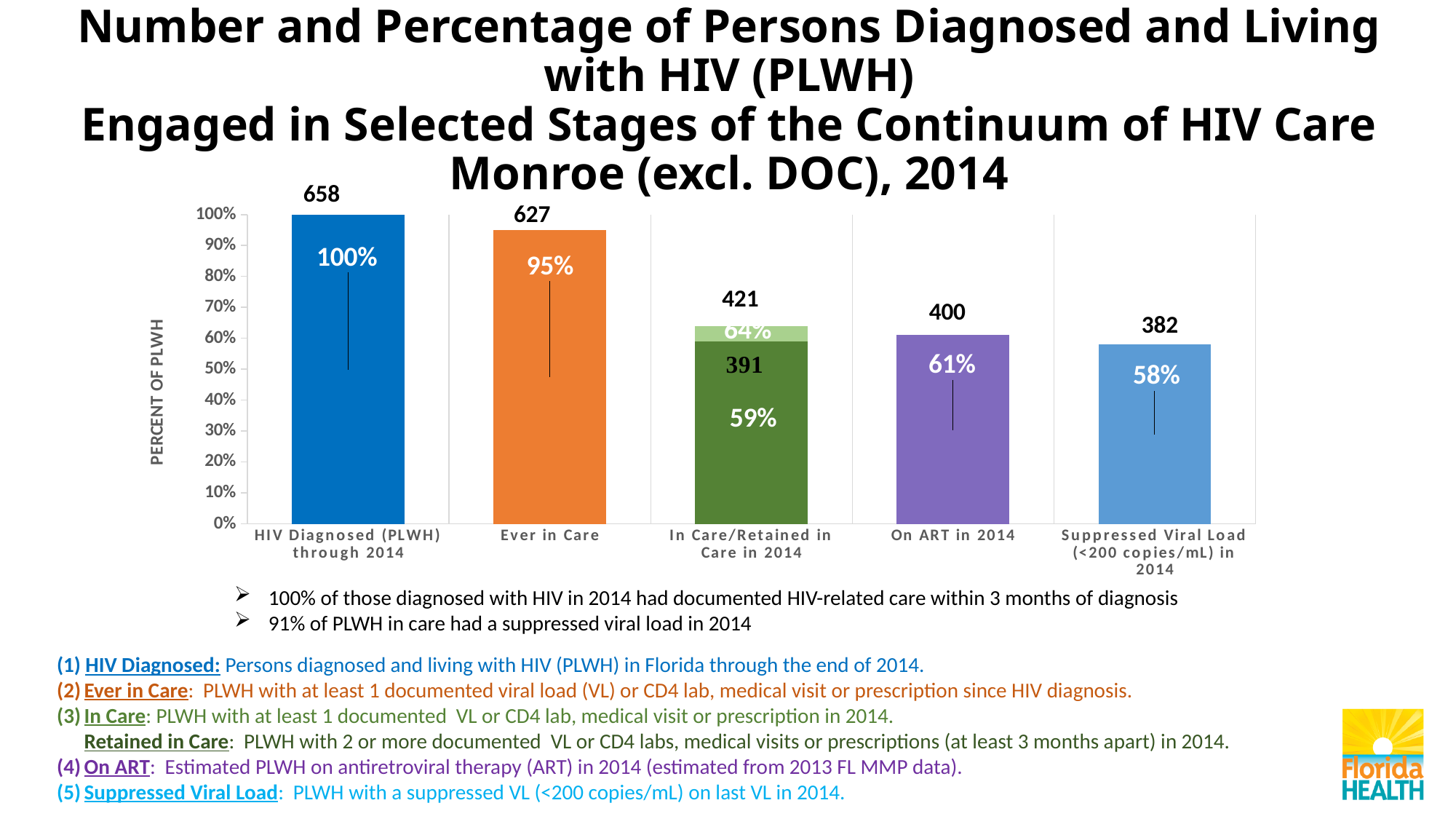
Which category has the lowest value in the chart? Suppressed Viral Load (<200 copies/mL) in 2014 What number is labelled above the In Care/Retained in Care in 2014 bar? 421 What percentage is shown on the Ever in Care bar? 95% Which is larger, the number for On ART in 2014 or the number for Suppressed Viral Load (<200 copies/mL) in 2014? On ART in 2014 What percentage is shown on the Suppressed Viral Load (<200 copies/mL) in 2014 bar? 58% What number is labelled above the bar for HIV Diagnosed (PLWH) through 2014? 658 What kind of chart is shown on the slide? bar chart What number is labelled above the On ART in 2014 bar? 400 What is the label of the y axis of the chart? PERCENT OF PLWH Which category has the highest value in the chart? HIV Diagnosed (PLWH) through 2014 What is the difference between the number for HIV Diagnosed (PLWH) through 2014 and the number for Ever in Care? 31 How many categories are shown on the x axis of the chart? 5